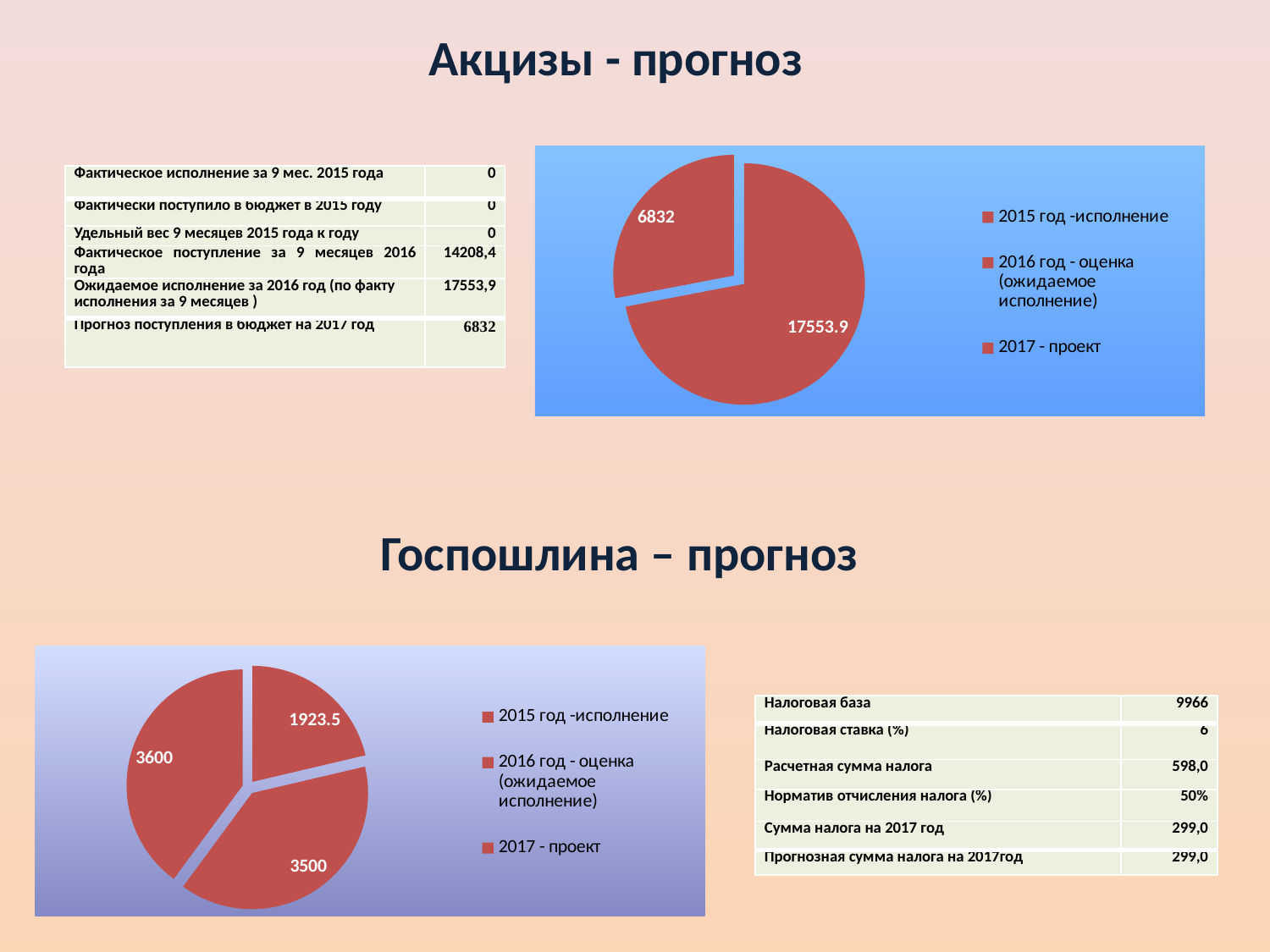
In the "Акцизы - прогноз" chart, what is the largest value labelled on the pie? 17553.9 In the "Акцизы - прогноз" chart, what is the value of the slice for "2017 - проект"? 6832 What kind of chart is the chart under the title "Госпошлина – прогноз"? pie chart In the "Акцизы - прогноз" chart, what is the difference between the two labelled slice values, 17553.9 and 6832? 10721.9 In the "Госпошлина – прогноз" chart, what is the smallest value labelled on the pie? 1923.5 In the "Госпошлина – прогноз" chart, what is the largest value labelled on the pie? 3600 What kind of chart is the chart under the title "Акцизы - прогноз"? pie chart In the "Госпошлина – прогноз" chart, what is the total of the three labelled slice values? 9023.5 In the "Акцизы - прогноз" chart, what is the smallest value labelled on the pie? 6832 In the "Госпошлина – прогноз" chart, what is the difference between the slices labelled 3600 and 3500? 100 How many slices does the pie in the "Госпошлина – прогноз" chart have? 3 How many entries does the legend of the "Акцизы - прогноз" chart list? 3